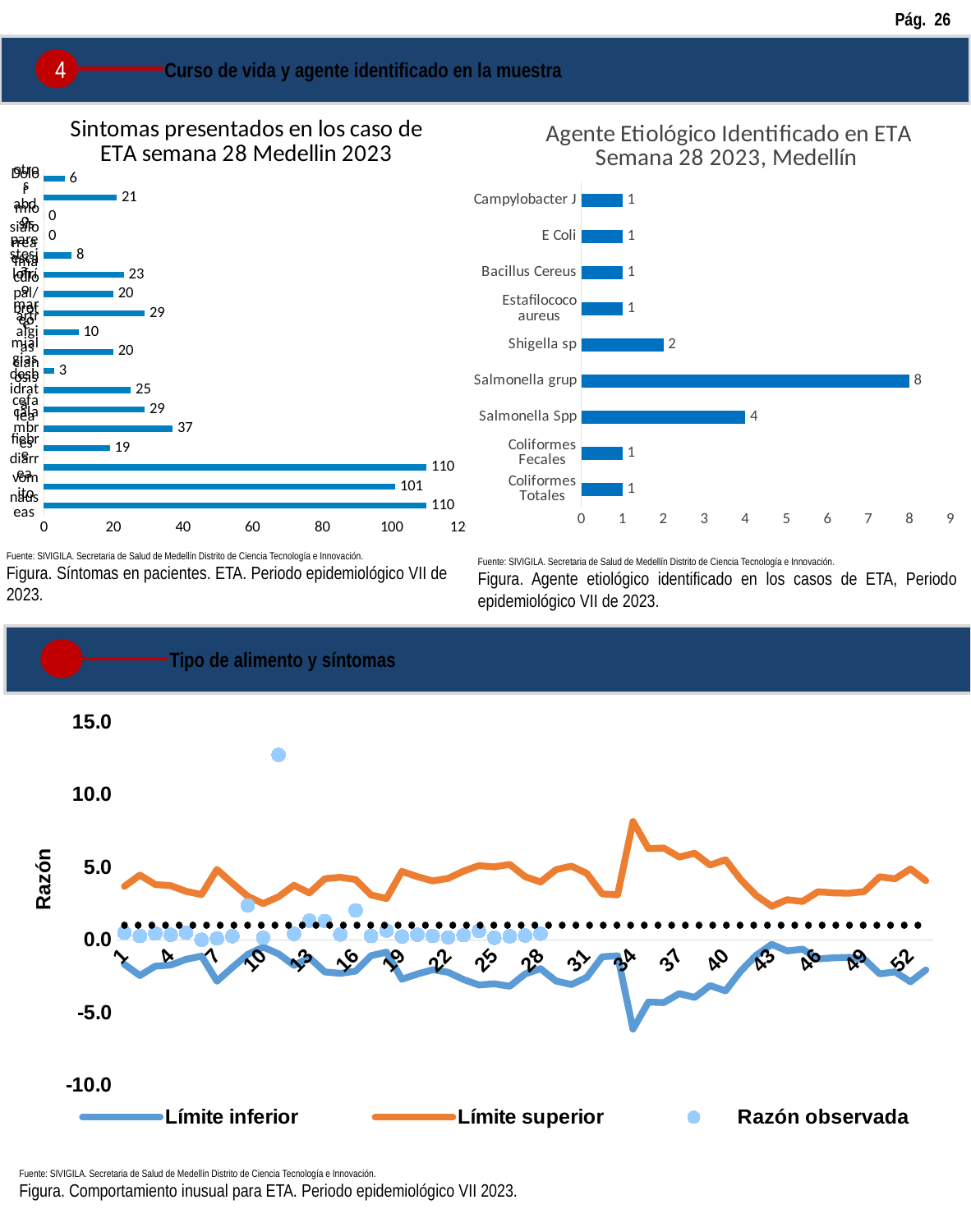
How many categories are shown in the chart titled 'Agente Etiológico Identificado en ETA Semana 28 2023, Medellín'? 9 In the chart titled 'Sintomas presentados en los caso de ETA semana 28 Medellin 2023', what is the highest value shown on a bar? 110 How many bars are shown in the chart titled 'Sintomas presentados en los caso de ETA semana 28 Medellin 2023'? 18 In the chart titled 'Agente Etiológico Identificado en ETA Semana 28 2023, Medellín', what is the value for Salmonella Spp? 4 In the chart titled 'Agente Etiológico Identificado en ETA Semana 28 2023, Medellín', which is larger, Shigella sp or E Coli? Shigella sp In the chart titled 'Agente Etiológico Identificado en ETA Semana 28 2023, Medellín', what is the value for Salmonella grup? 8 In the chart titled 'Agente Etiológico Identificado en ETA Semana 28 2023, Medellín', what is the difference between Salmonella grup and Salmonella Spp? 4 How many series does the legend of the bottom chart (Tipo de alimento y síntomas section) list? 3 In the chart titled 'Agente Etiológico Identificado en ETA Semana 28 2023, Medellín', what is the value for Shigella sp? 2 What are the legend entries of the bottom chart on the slide? Límite inferior, Límite superior, Razón observada What kind of chart is the one titled 'Agente Etiológico Identificado en ETA Semana 28 2023, Medellín'? Bar chart In the chart titled 'Agente Etiológico Identificado en ETA Semana 28 2023, Medellín', which agent has the highest value? Salmonella grup